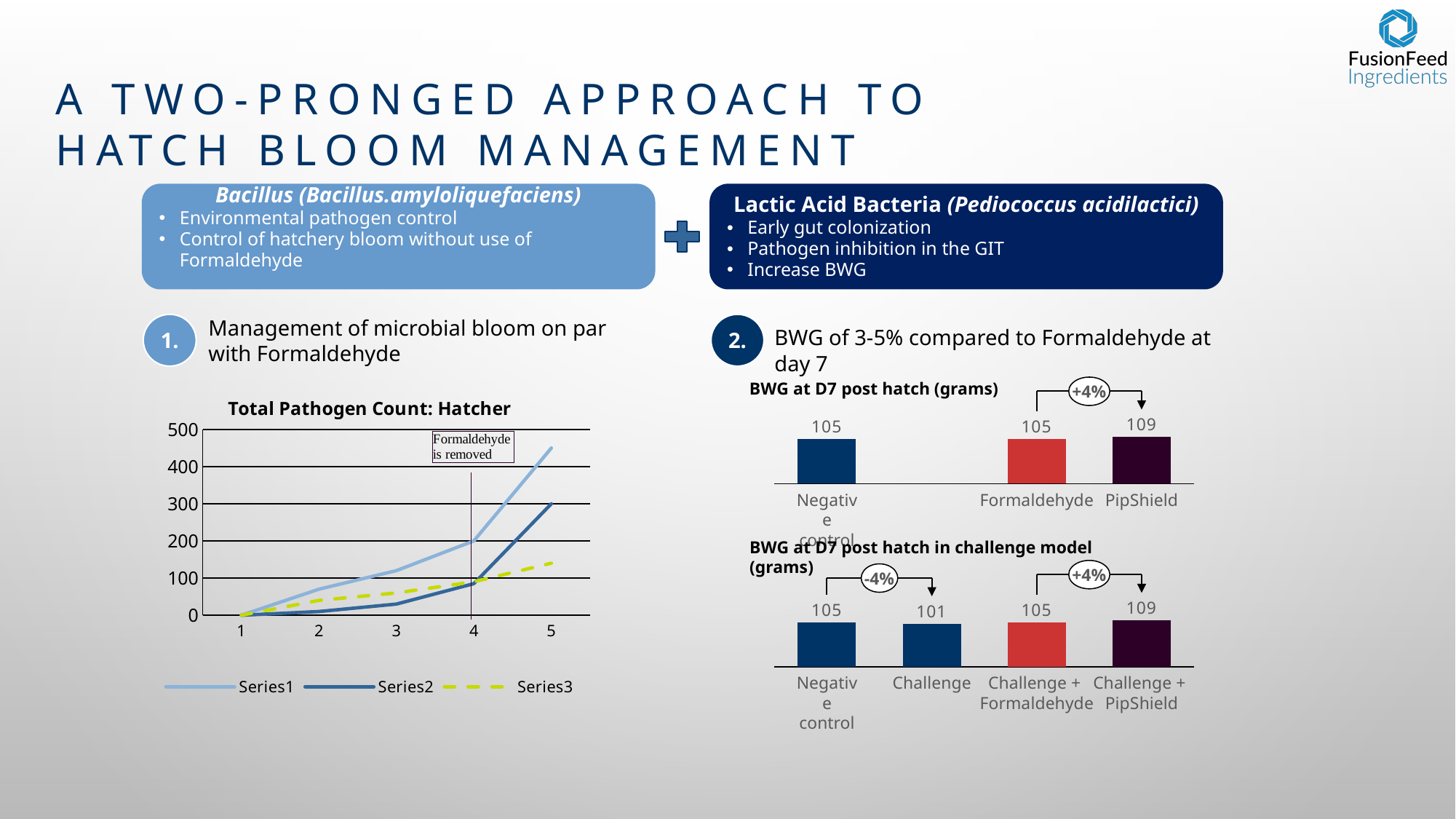
In 'BWG at D7 post hatch (grams)', what is the difference between PipShield and Formaldehyde? 4 In 'BWG at D7 post hatch in challenge model (grams)', which category has the lowest value? Challenge How many series does the legend of 'Total Pathogen Count: Hatcher' list? 3 In 'Total Pathogen Count: Hatcher', is the value of Series3 at x = 5 greater or less than 200? less In 'Total Pathogen Count: Hatcher', is the value of Series1 at x = 5 greater or less than 400? greater In 'BWG at D7 post hatch (grams)', what is the value for PipShield? 109 What kind of chart is 'Total Pathogen Count: Hatcher'? line chart In 'Total Pathogen Count: Hatcher', which series has the highest value at x = 5? Series1 How many bars are in 'BWG at D7 post hatch in challenge model (grams)'? 4 In 'Total Pathogen Count: Hatcher', what does the annotation at x = 4 say? Formaldehyde is removed In 'BWG at D7 post hatch in challenge model (grams)', what is the value for Challenge + Formaldehyde? 105 In 'Total Pathogen Count: Hatcher', does Series1 rise or fall from x = 1 to x = 5? rise